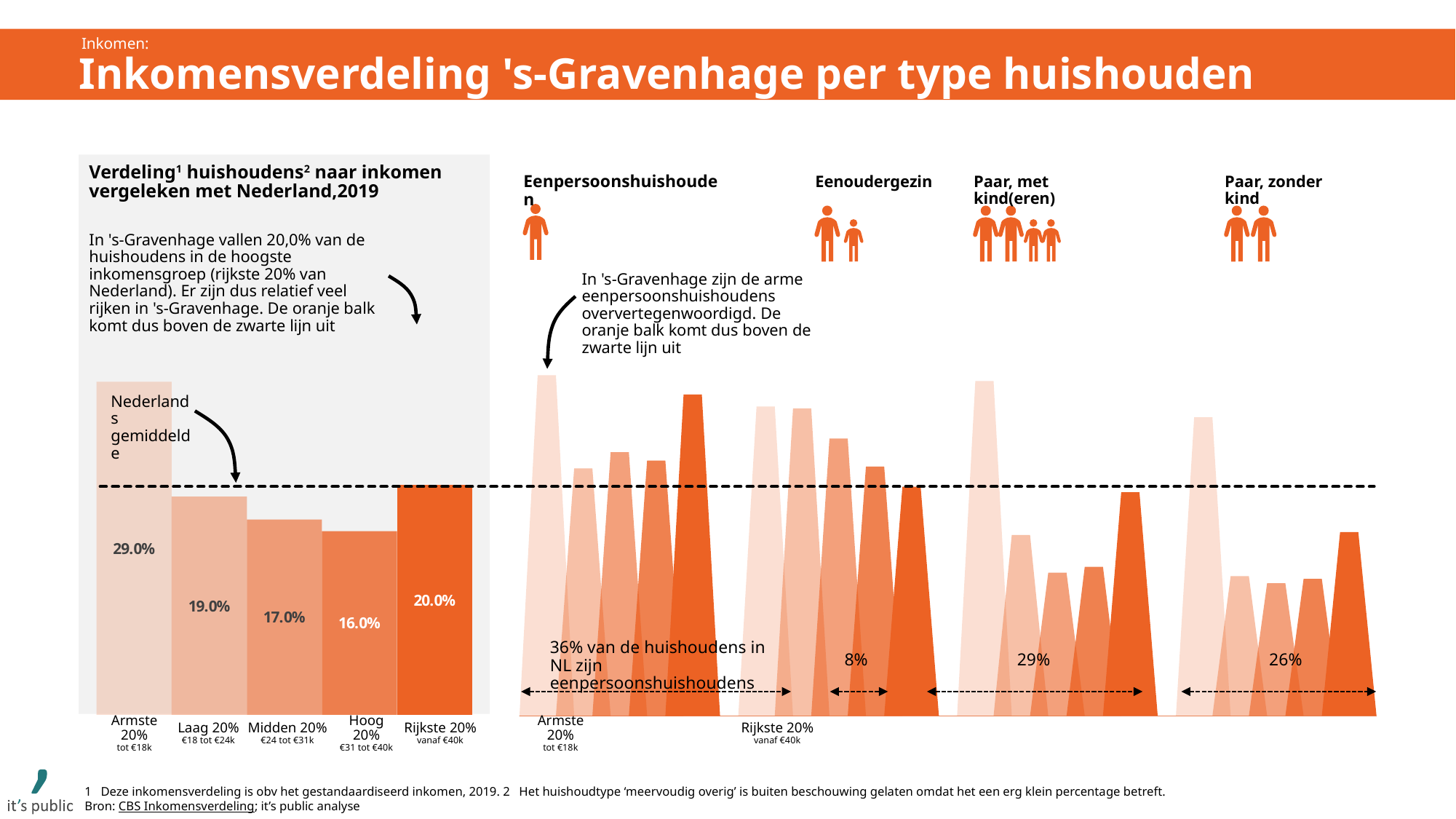
On the left chart, what does the dashed horizontal line represent? Nederlands gemiddelde On the left chart, which income group has the lowest value? Hoog 20% On the left chart 'Verdeling huishoudens naar inkomen vergeleken met Nederland, 2019', what is the value for Armste 20%? 29.0% On the left chart, what is the difference between the values for Armste 20% and Laag 20%? 10.0% What kind of chart is the left chart 'Verdeling huishoudens naar inkomen vergeleken met Nederland, 2019'? bar chart On the right-hand charts, what percentage is shown for Paar, met kind(eren)? 29% On the left chart, what is the value for Midden 20%? 17.0% On the left chart, which income group has the highest value? Armste 20% On the left chart, which is larger: the value for Rijkste 20% or the value for Hoog 20%? Rijkste 20% On the left chart, how many income groups are shown? 5 On the left chart, what is the value for Rijkste 20%? 20.0% On the right-hand charts, what percentage of households in NL are eenpersoonshuishoudens? 36%